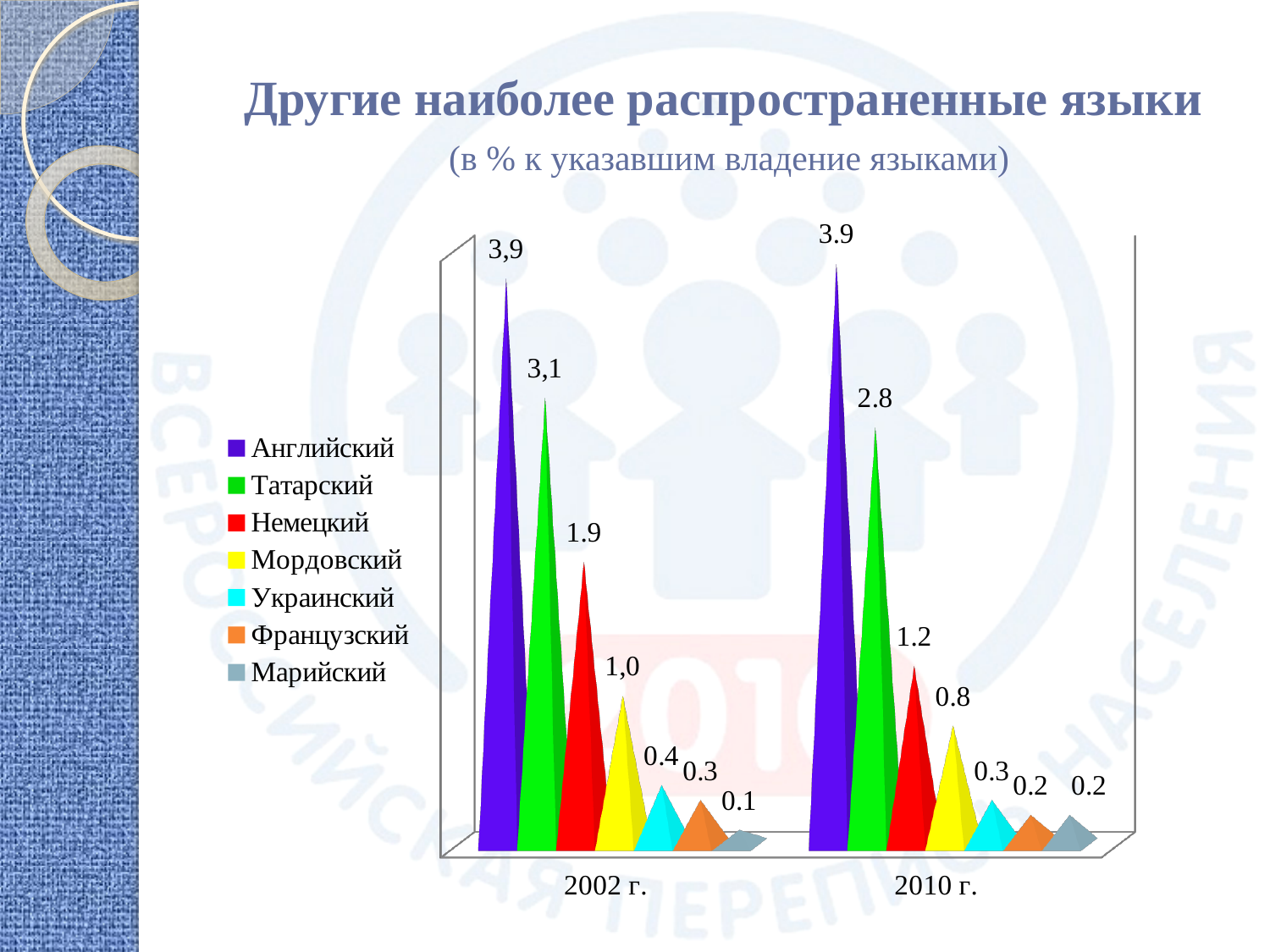
What is the value for Мордовский in 2010 г.? 0.8 What is the value for Немецкий in 2002 г.? 1.9 How many categories are shown on the x axis? 2 Which is larger: the value for Немецкий in 2002 г. or in 2010 г.? 2002 г. What is the difference between the values for Татарский in 2002 г. and 2010 г.? 0.3 Which language has the lowest value in 2002 г.? Марийский What is the value for Марийский in 2002 г.? 0.1 What is the value for Татарский in 2010 г.? 2.8 Which language has the highest value in 2010 г.? Английский What is the value for Английский in 2002 г.? 3,9 How many series does the legend list? 7 What kind of chart is shown on the slide? Bar chart